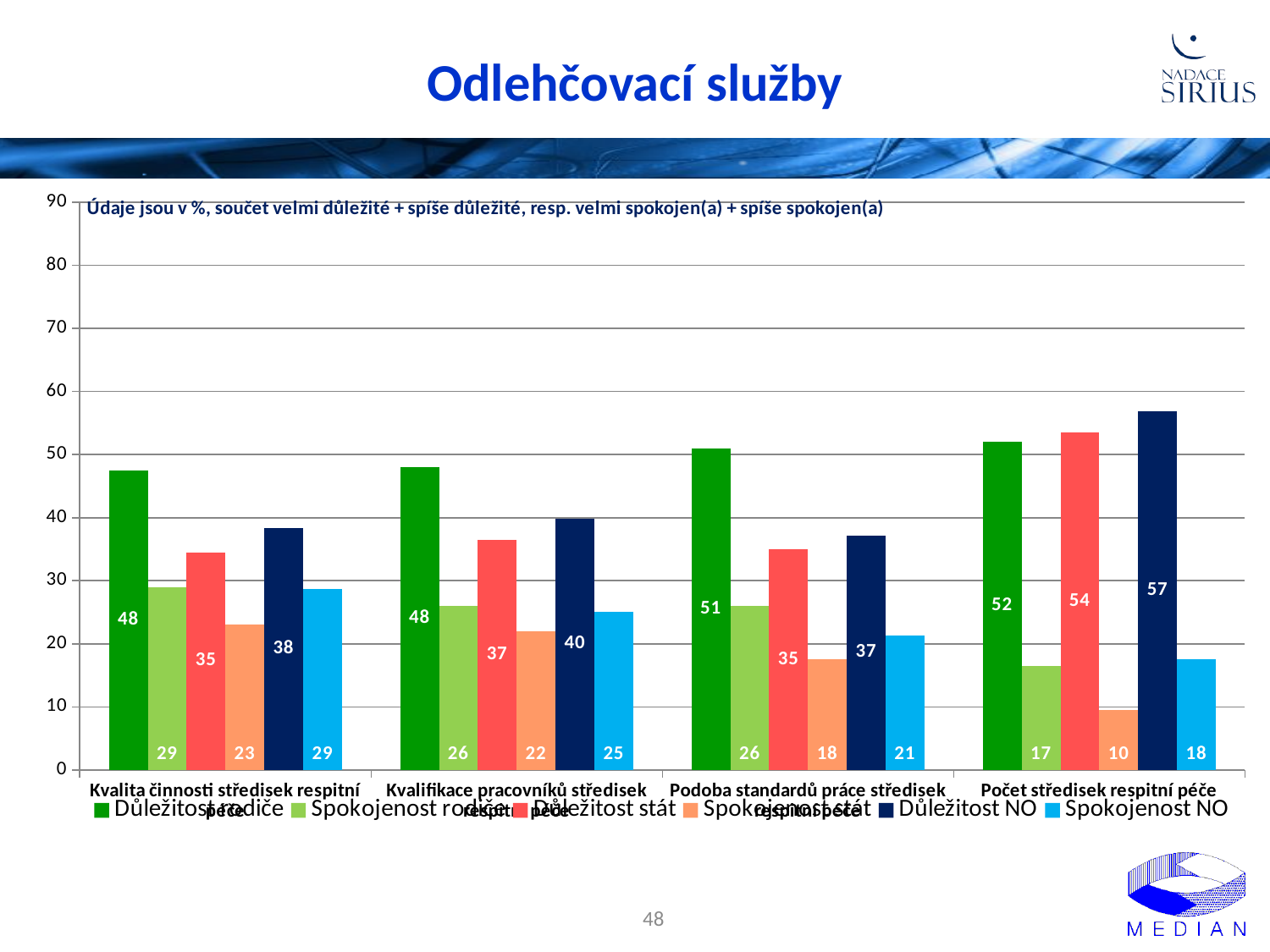
How many categories are shown on the x axis? 4 What colour are the Důležitost rodiče bars? green Which category has the lowest value for Spokojenost stát? Počet středisek respitní péče Is the value of Důležitost NO for Kvalita činnosti středisek respitní péče greater or less than 40? less Which category has the highest value for Důležitost rodiče? Počet středisek respitní péče What is the difference between Důležitost NO and Spokojenost NO for Počet středisek respitní péče? 39 What type of chart is shown on the slide? bar chart What is the value of Důležitost NO for Počet středisek respitní péče? 57 What is the value of Spokojenost stát for Kvalita činnosti středisek respitní péče? 23 How many series does the legend list? 6 Which is larger for Podoba standardů práce středisek respitní péče: Důležitost rodiče or Důležitost stát? Důležitost rodiče What is the value of Důležitost stát for Kvalifikace pracovníků středisek respitní péče? 37